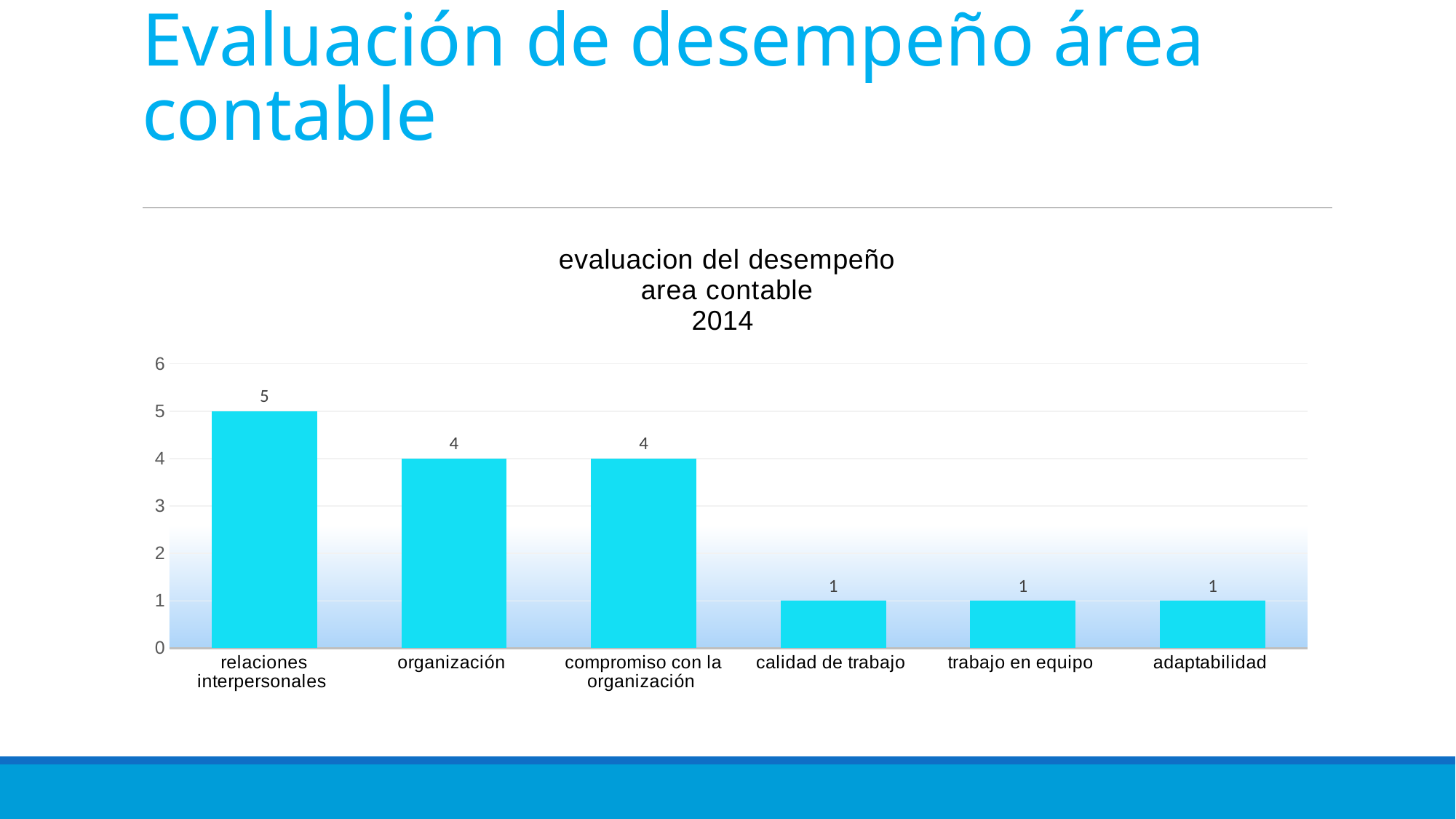
What is the value for calidad de trabajo? 1 What is the value for adaptabilidad? 1 What is the difference between the values for relaciones interpersonales and organización? 1 How many categories are shown on the x axis? 6 Which category has the highest value? relaciones interpersonales What is the value for organización? 4 What is the difference between the values for compromiso con la organización and trabajo en equipo? 3 Is the value for compromiso con la organización greater or less than 3? greater What is the value for relaciones interpersonales? 5 What year is shown in the chart title? 2014 What kind of chart is shown on the slide? bar chart Which is larger, the value for organización or the value for calidad de trabajo? organización